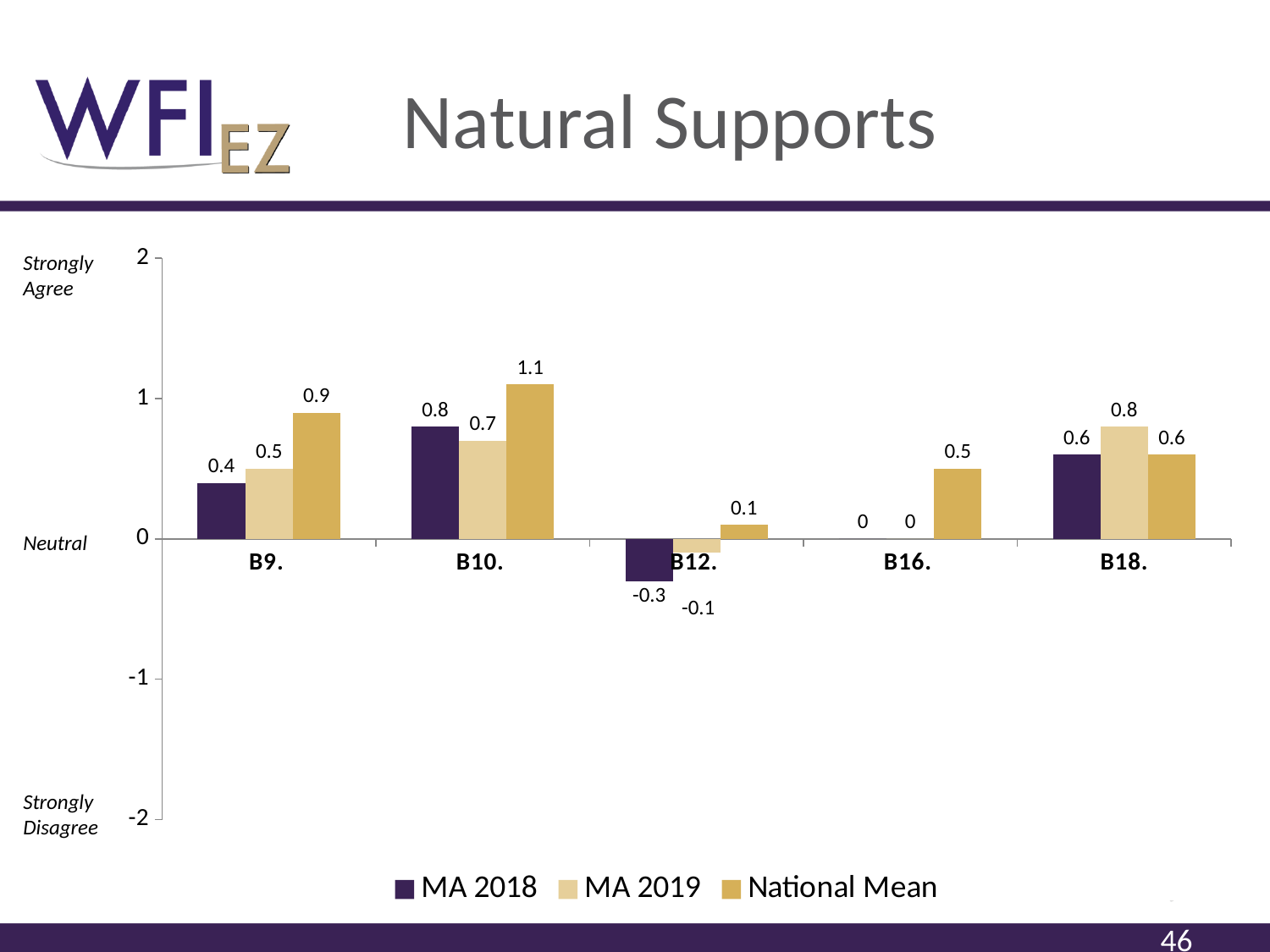
How many series does the legend list? 3 Which category has the highest National Mean value? B10. What is the MA 2019 value for B18.? 0.8 What is the MA 2018 value for B12.? -0.3 How many categories are shown on the x axis? 5 Which category has the lowest MA 2018 value? B12. What kind of chart is shown on the slide? Bar chart What is the National Mean value for B10.? 1.1 What is the title of the slide? Natural Supports What is the MA 2018 value for B16.? 0 What is the difference between the National Mean and MA 2018 values for B9.? 0.5 Which is larger for B10., the MA 2018 value or the MA 2019 value? MA 2018